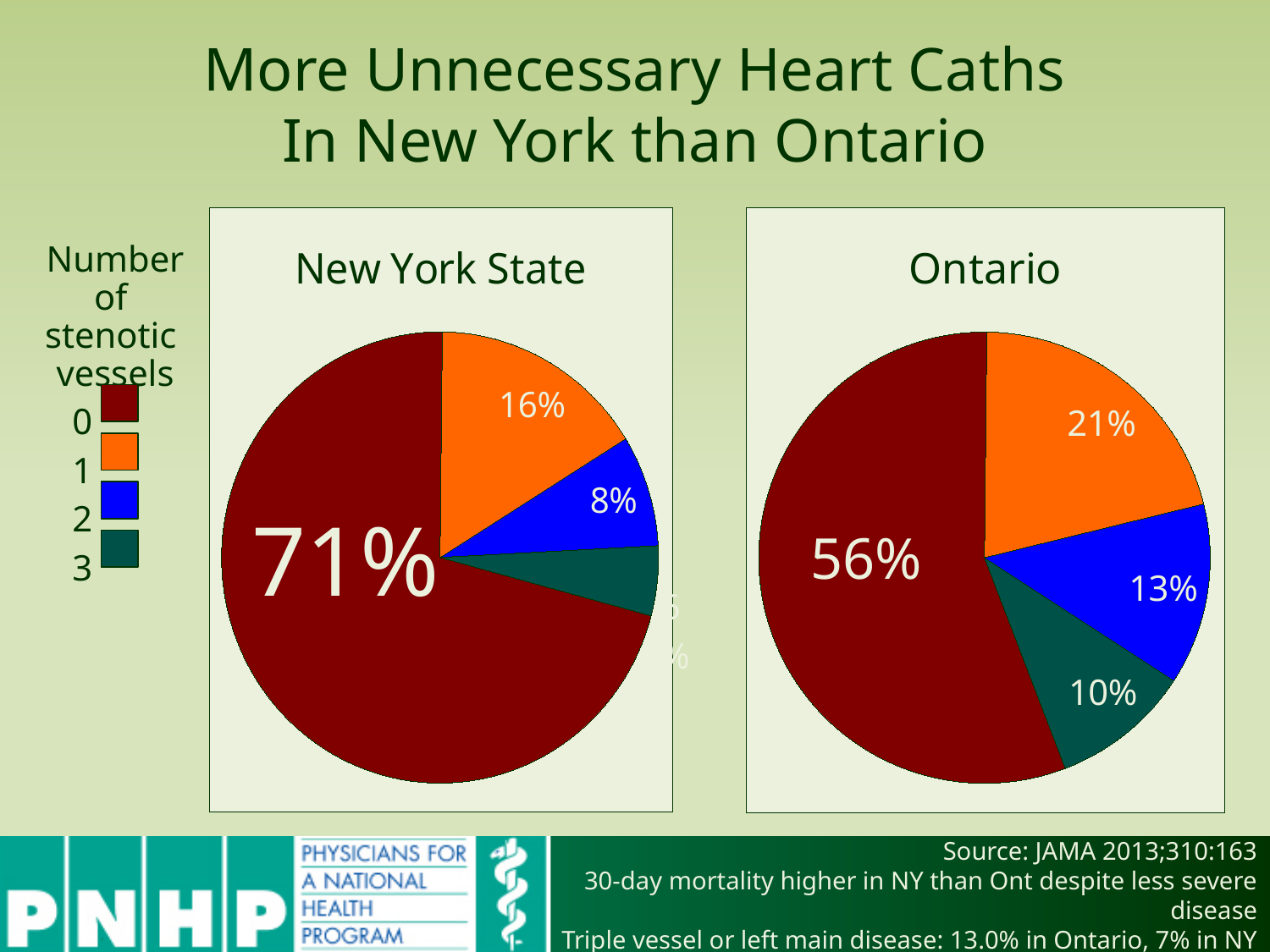
In the Ontario pie chart, what percentage is shown for 1 stenotic vessel? 21% In the Ontario pie chart, what share of patients had 0 stenotic vessels? 56% In the legend, which colour represents 1 stenotic vessel? Orange In the Ontario pie chart, what percentage is shown for 3 stenotic vessels? 10% How many categories (numbers of stenotic vessels) does the legend list? 4 In the Ontario pie chart, which number of stenotic vessels has the largest slice? 0 In the Ontario pie chart, which number of stenotic vessels has the smallest slice? 3 In the New York State pie chart, what share of patients had 0 stenotic vessels? 71% What is the difference between the 0-vessel share in New York State and the 0-vessel share in Ontario? 15% In the New York State pie chart, what percentage is shown for 2 stenotic vessels? 8% What type of chart is used to show the New York State and Ontario data? Pie chart Which has a larger share for 2 stenotic vessels, New York State or Ontario? Ontario